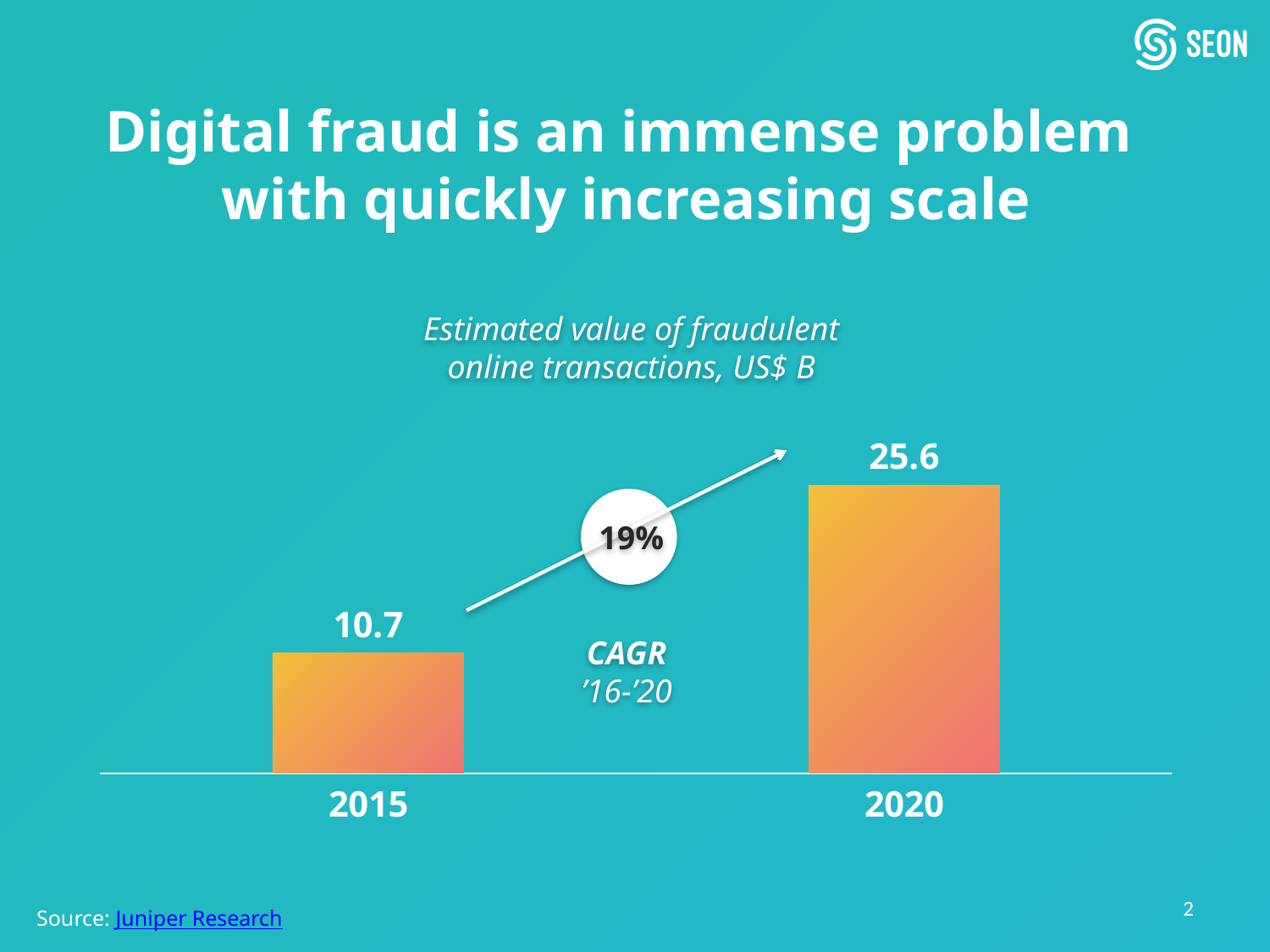
What unit is the chart's data expressed in, according to its title? US$ B How many years are shown on the chart? 2 What is the estimated value of fraudulent online transactions for 2020? 25.6 What is the estimated value of fraudulent online transactions for 2015? 10.7 What is the difference between the 2020 and 2015 values? 14.9 Which year has the higher estimated value of fraudulent online transactions? 2020 Is the value for 2020 larger or smaller than the value for 2015? larger Do the values rise or fall from 2015 to 2020? rise What kind of chart is shown on the slide? bar chart Which year has the lower estimated value of fraudulent online transactions? 2015 What CAGR for '16-'20 is shown on the chart? 19%